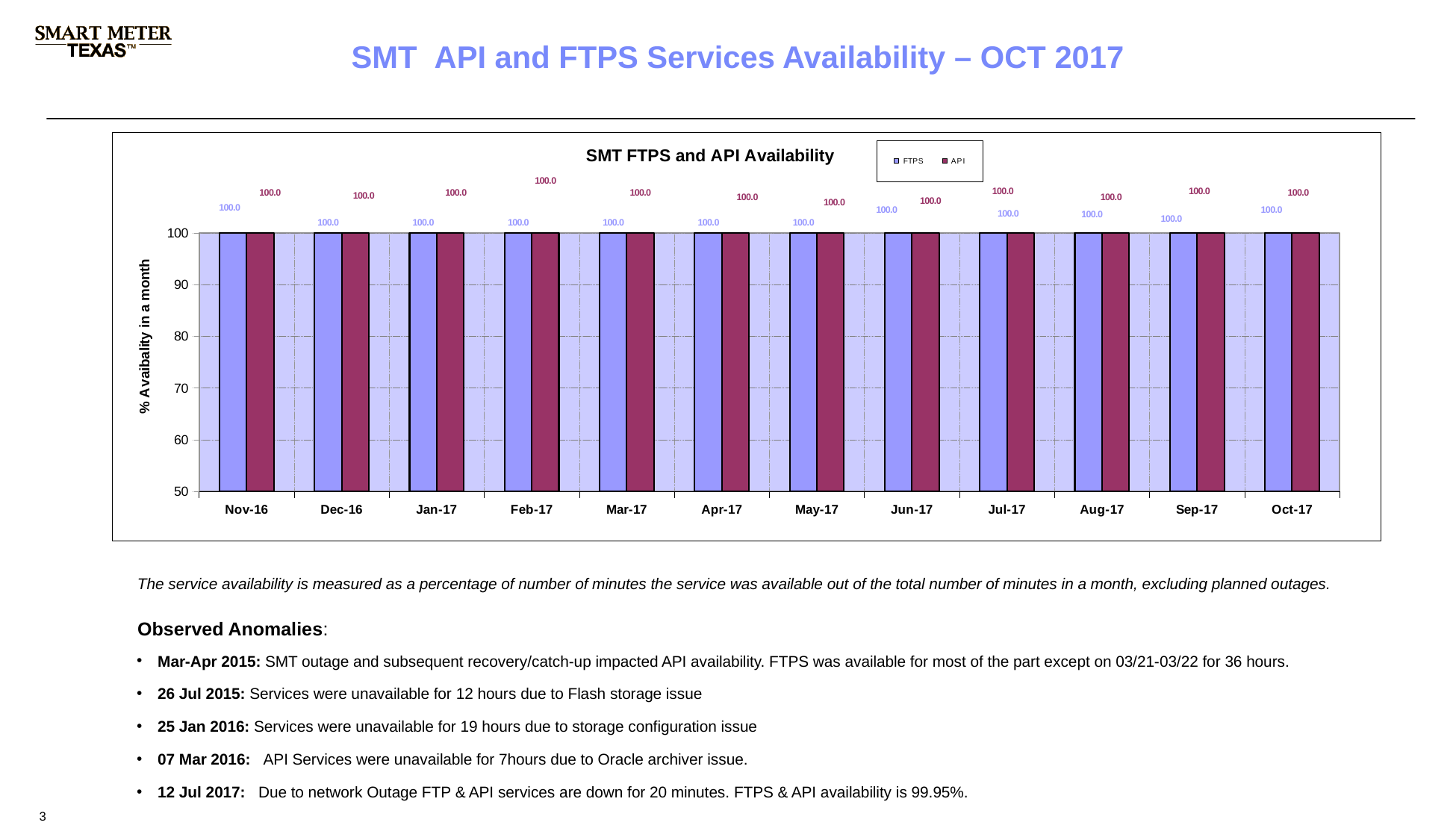
What is the API availability value for Jul-17? 100.0 What is the FTPS availability value for Nov-16? 100.0 What is the difference between the FTPS and API availability values for Jun-17? 0.0 What is the FTPS availability value for Oct-17? 100.0 What is the title of the chart? SMT FTPS and API Availability What is the API availability value for Mar-17? 100.0 How many months are shown on the x axis of the chart? 12 Is the API availability value for Dec-16 greater or less than 90? greater How many series does the chart legend list? 2 What is the label on the y axis of the chart? % Avaibality in a month Do the FTPS availability values rise, fall, or stay flat from Nov-16 to Oct-17? stay flat What kind of chart is shown on the slide? bar chart